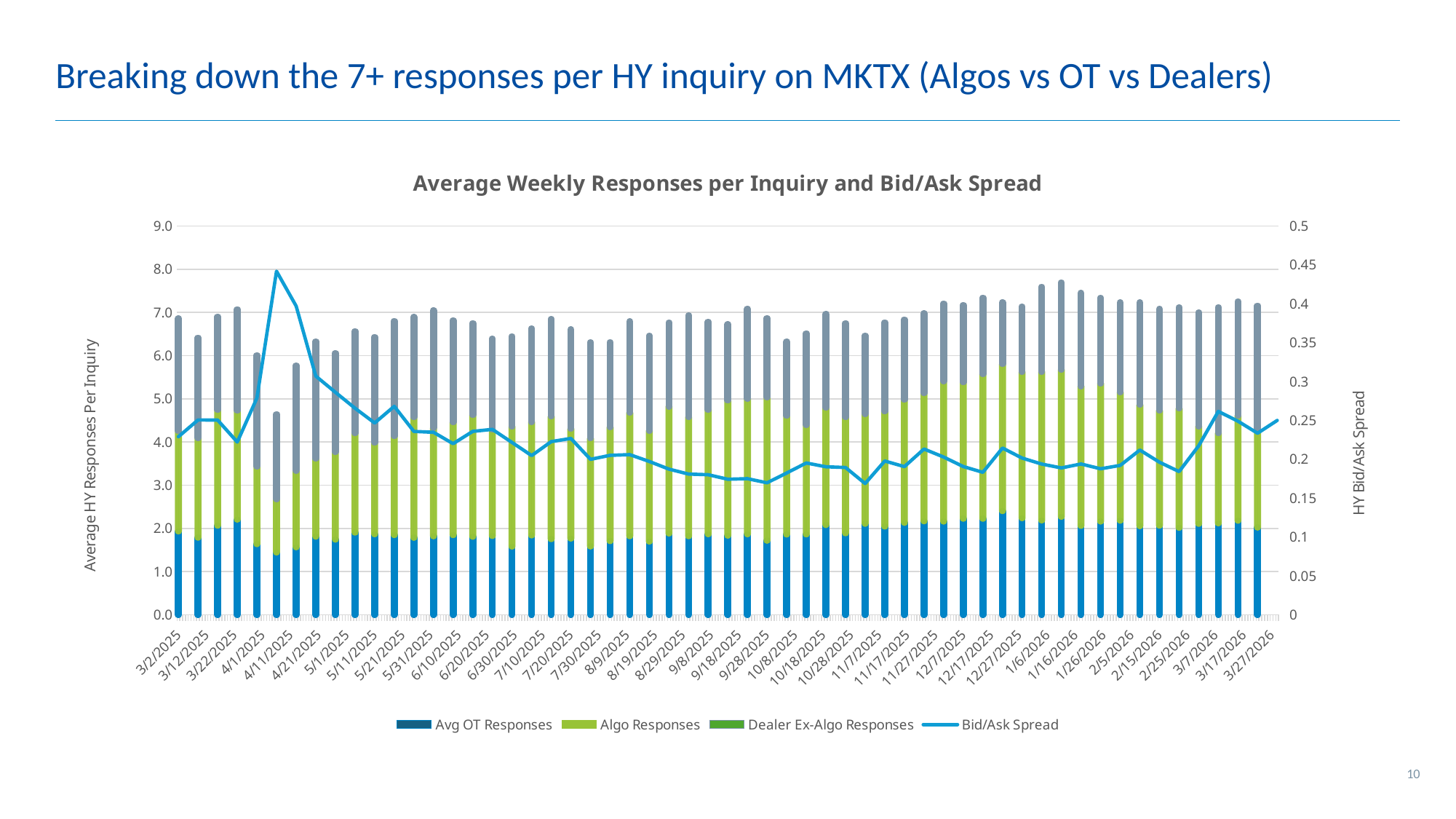
Does the Bid/Ask Spread line rise or fall between 4/11/2025 and 5/11/2025? fall What kind of chart is shown on the slide? Stacked bar chart combined with a line Is the Avg OT Responses value at 4/11/2025 greater or less than 2.0? less Is the Bid/Ask Spread value at 11/7/2025 greater or less than 0.2? less How many series does the chart's legend list? 4 Is the total stacked bar at 1/16/2026 greater or less than 7.0? greater What is the title of the chart? Average Weekly Responses per Inquiry and Bid/Ask Spread What is the label of the right-hand vertical axis? HY Bid/Ask Spread